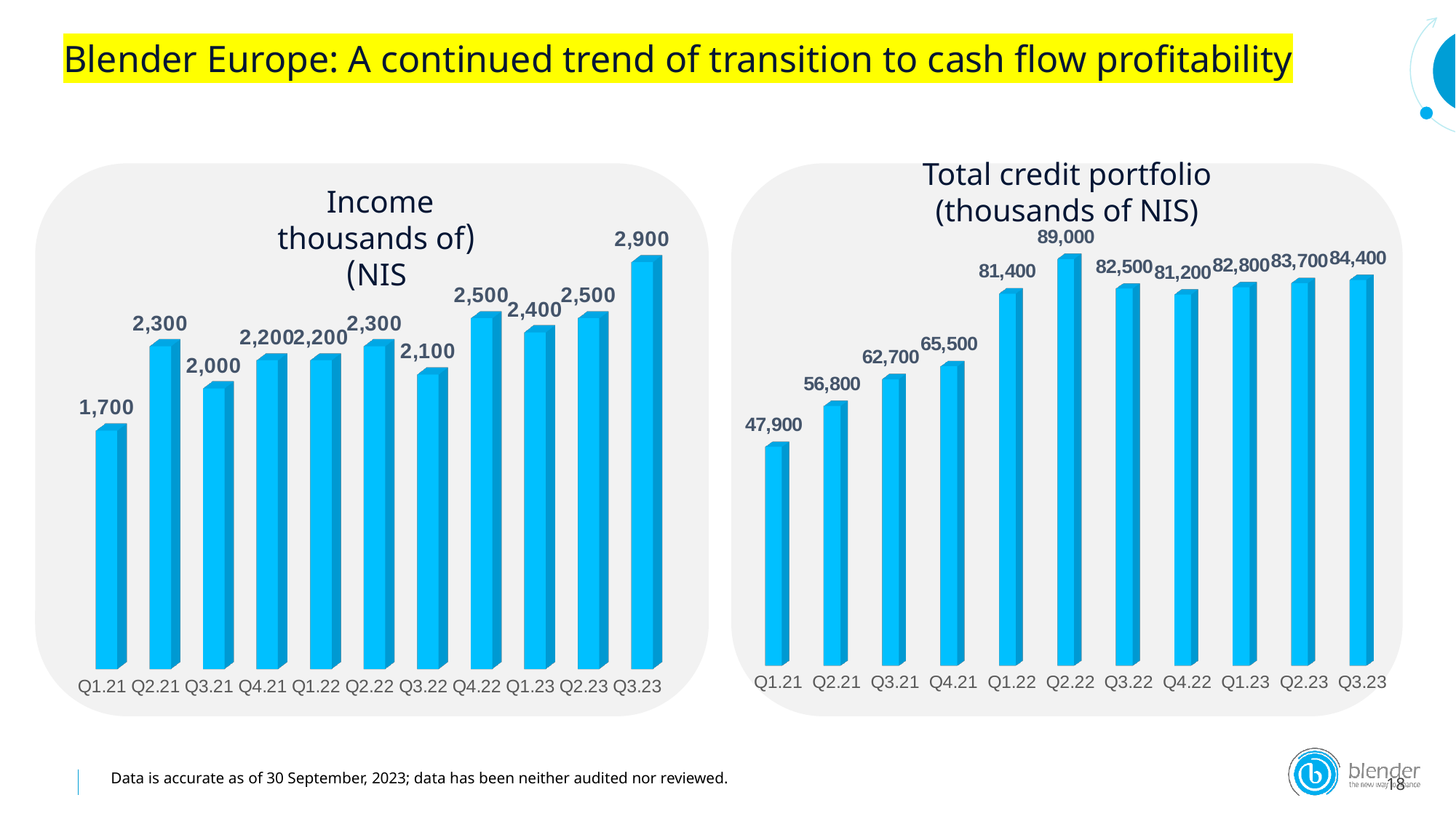
In the Income chart, which quarter has the highest value? Q3.23 In the Income chart, what is the value for Q3.23? 2,900 In the Total credit portfolio chart, what is the value for Q2.22? 89,000 In the Total credit portfolio chart, what is the difference between Q3.23 and Q1.21? 36,500 In the Income chart, what is the value for Q1.21? 1,700 In the Total credit portfolio chart, which quarter has the lowest value? Q1.21 In the Income chart, which quarter has the lowest value? Q1.21 In the Total credit portfolio chart, which is larger, Q1.22 or Q4.21? Q1.22 How many quarters are shown in the Income chart? 11 In the Income chart, what is the difference between Q3.23 and Q1.21? 1,200 What kind of chart is the Total credit portfolio chart? Bar chart In the Total credit portfolio chart, which quarter has the highest value? Q2.22